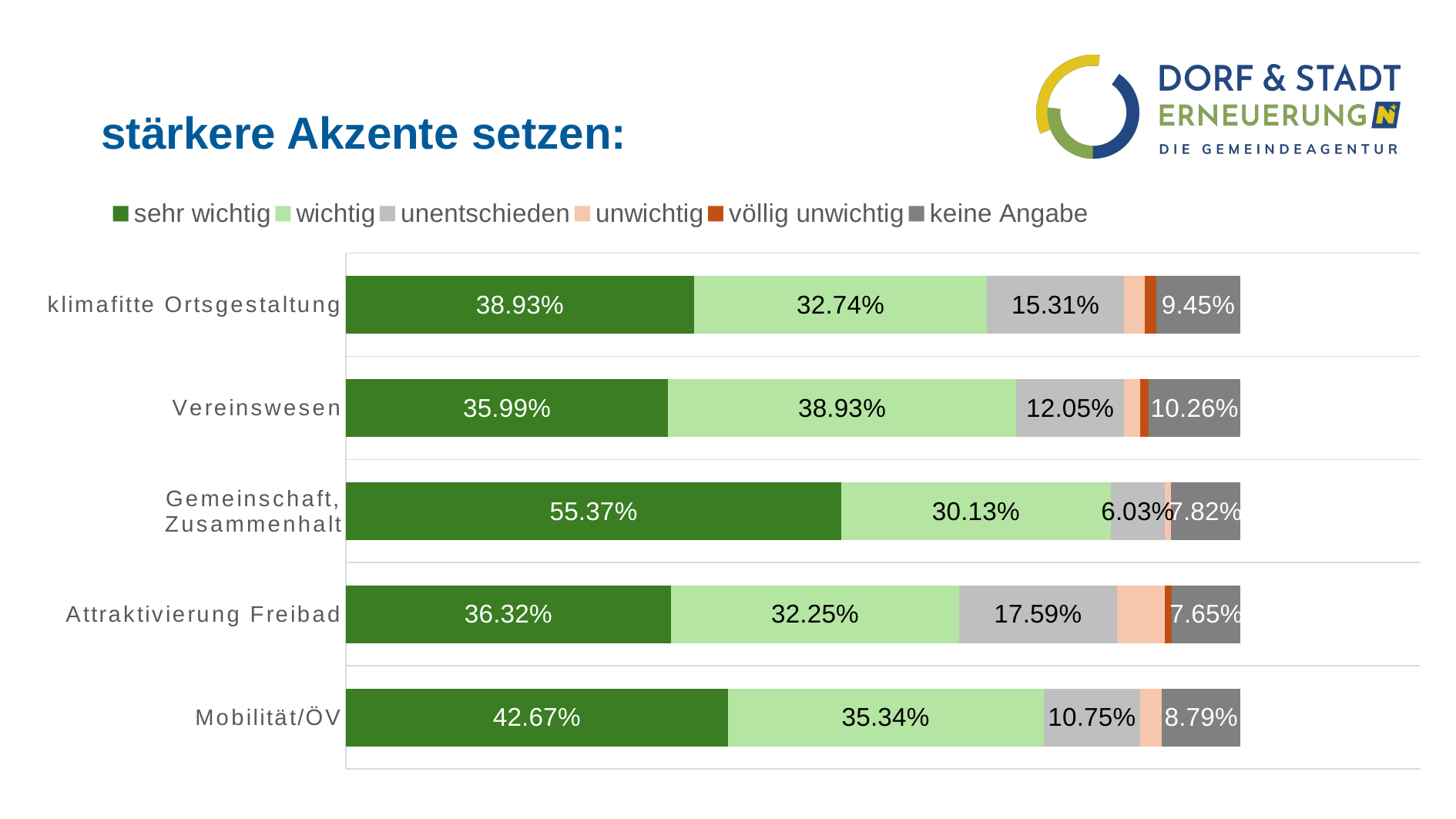
Which legend entry is shown in dark green? sehr wichtig What is the 'unentschieden' value for Attraktivierung Freibad? 17.59% Which category has the highest 'sehr wichtig' share? Gemeinschaft, Zusammenhalt What is the difference in 'sehr wichtig' between Gemeinschaft, Zusammenhalt and Mobilität/ÖV? 12.70 percentage points How many categories are plotted on the chart? 5 Which has the larger 'wichtig' share, Mobilität/ÖV or Attraktivierung Freibad? Mobilität/ÖV How many series does the legend list? 6 What is the 'sehr wichtig' value for Gemeinschaft, Zusammenhalt? 55.37% What is the 'keine Angabe' value for Mobilität/ÖV? 8.79% What is the 'wichtig' value for Vereinswesen? 38.93% Which category has the lowest 'unentschieden' share? Gemeinschaft, Zusammenhalt What kind of chart is shown on the slide? stacked bar chart